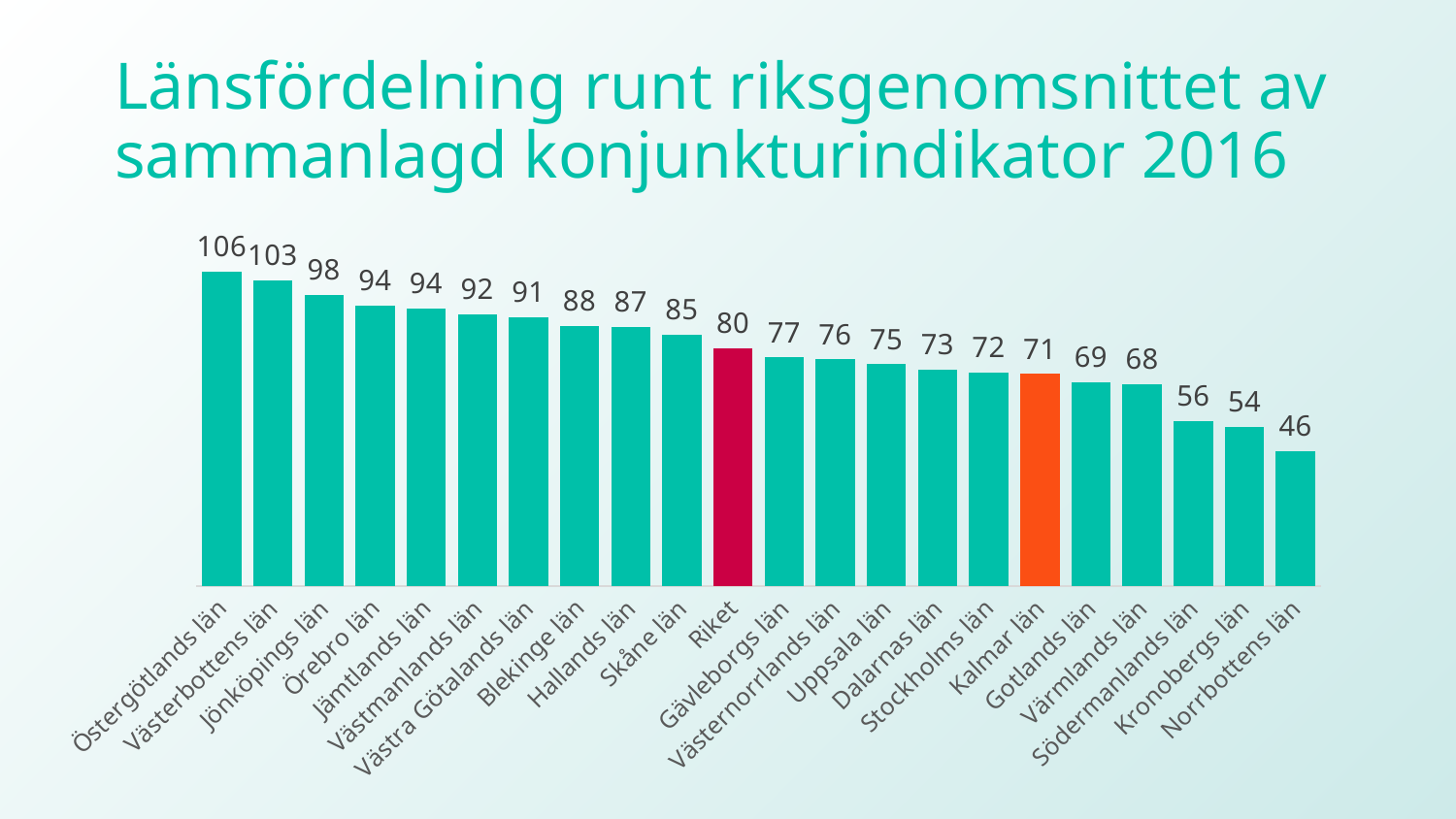
What kind of chart is shown on the slide? Bar chart Do the values rise or fall from left to right along the x axis? Fall Which category has the highest value? Östergötlands län How many bars are shown in the chart? 22 What is the value for Stockholms län? 72 Which bar is coloured red in the chart? Riket Which is larger, the value for Skåne län or the value for Gävleborgs län? Skåne län What is the value for Kalmar län? 71 What is the difference between the values for Östergötlands län and Norrbottens län? 60 What is the difference between the values for Riket and Kalmar län? 9 Which category has the lowest value? Norrbottens län What is the value for Riket? 80